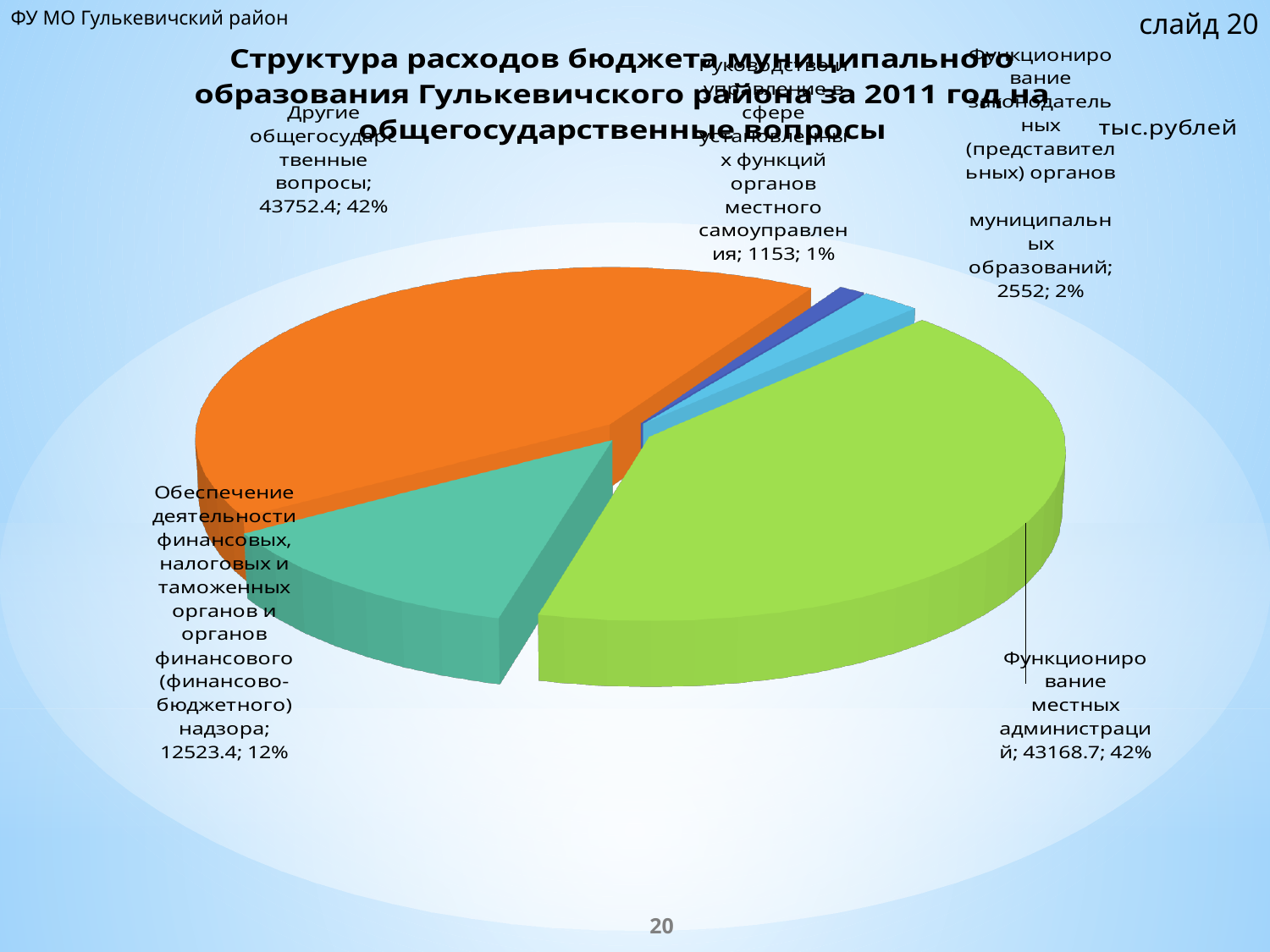
Which category has the smallest value? Руководство и управление в сфере установленных функций органов местного самоуправления What is the value for "Обеспечение деятельности финансовых, налоговых и таможенных органов и органов финансового (финансово-бюджетного) надзора"? 12523.4 What share of the pie does "Другие общегосударственные вопросы" represent? 42% What type of chart is shown on the slide? pie chart What share of the pie does "Функционирование законодательных (представительных) органов муниципальных образований" represent? 2% Which category has the largest value? Другие общегосударственные вопросы What is the difference between the values for "Другие общегосударственные вопросы" and "Функционирование местных администраций"? 583.7 In what units are the values on the chart given? тыс.рублей What is the value for "Функционирование местных администраций"? 43168.7 Which is larger: the value for "Функционирование законодательных (представительных) органов муниципальных образований" or for "Руководство и управление в сфере установленных функций органов местного самоуправления"? Функционирование законодательных (представительных) органов муниципальных образований How many slices does the pie chart have? 5 What is the value for "Руководство и управление в сфере установленных функций органов местного самоуправления"? 1153